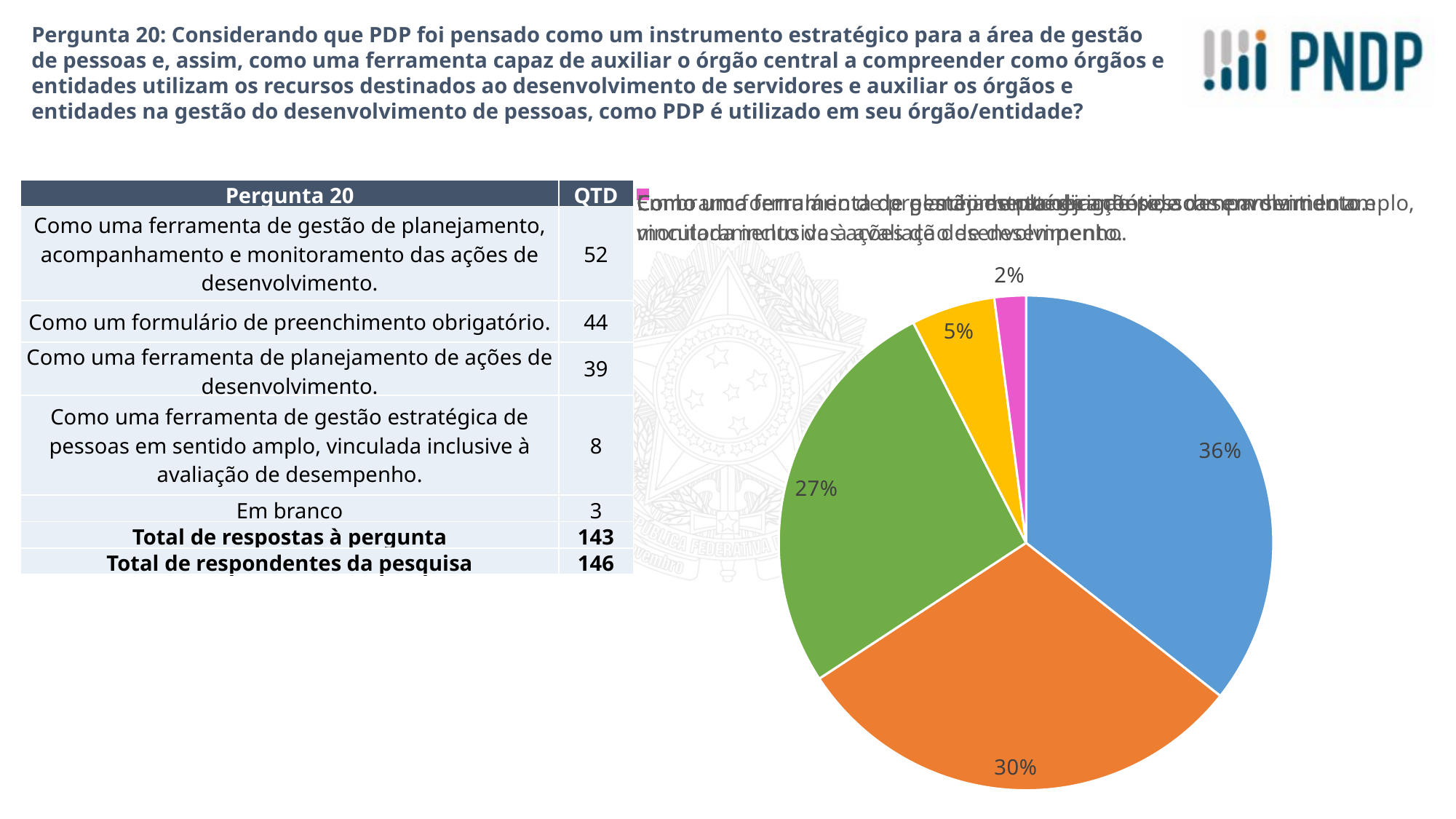
What share does the blue slice of the pie chart represent? 36% How many slices does the pie chart have? 5 What share does the yellow slice of the pie chart represent? 5% What is the share of the largest slice in the pie chart? 36% What is the share of the smallest slice in the pie chart? 2% What is the difference in percentage points between the largest slice (36%) and the second largest slice (30%)? 6 What colour is the slice labelled 2% in the pie chart? pink What is the difference in percentage points between the yellow slice (5%) and the pink slice (2%)? 3 What share does the green slice of the pie chart represent? 27% Which slice is larger in the pie chart, the green one or the orange one? the orange one What kind of chart is shown on the slide? pie chart